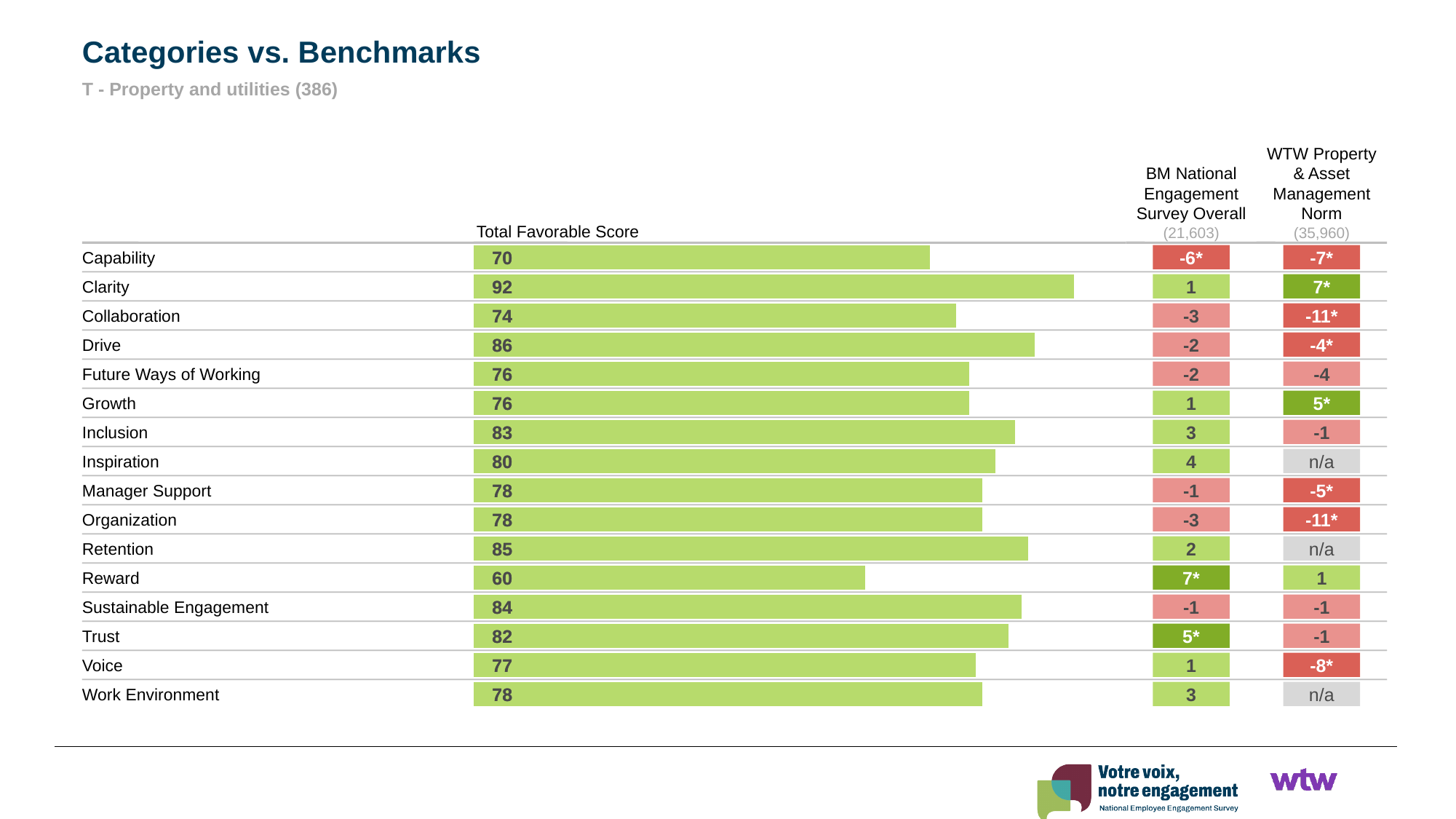
What kind of chart is used to show the Total Favorable Score? Bar chart Which has a higher Total Favorable Score, Drive or Inclusion? Drive What is the Total Favorable Score for Sustainable Engagement? 84 What is the title of the slide containing the chart? Categories vs. Benchmarks Which category has the highest Total Favorable Score? Clarity How many categories are shown in the chart? 16 What is the Total Favorable Score for Reward? 60 Which category has the lowest Total Favorable Score? Reward What is the Total Favorable Score for Clarity? 92 What is the Total Favorable Score for Voice? 77 What is the difference between the Total Favorable Scores for Clarity and Reward? 32 What is the difference between the Total Favorable Scores for Retention and Capability? 15